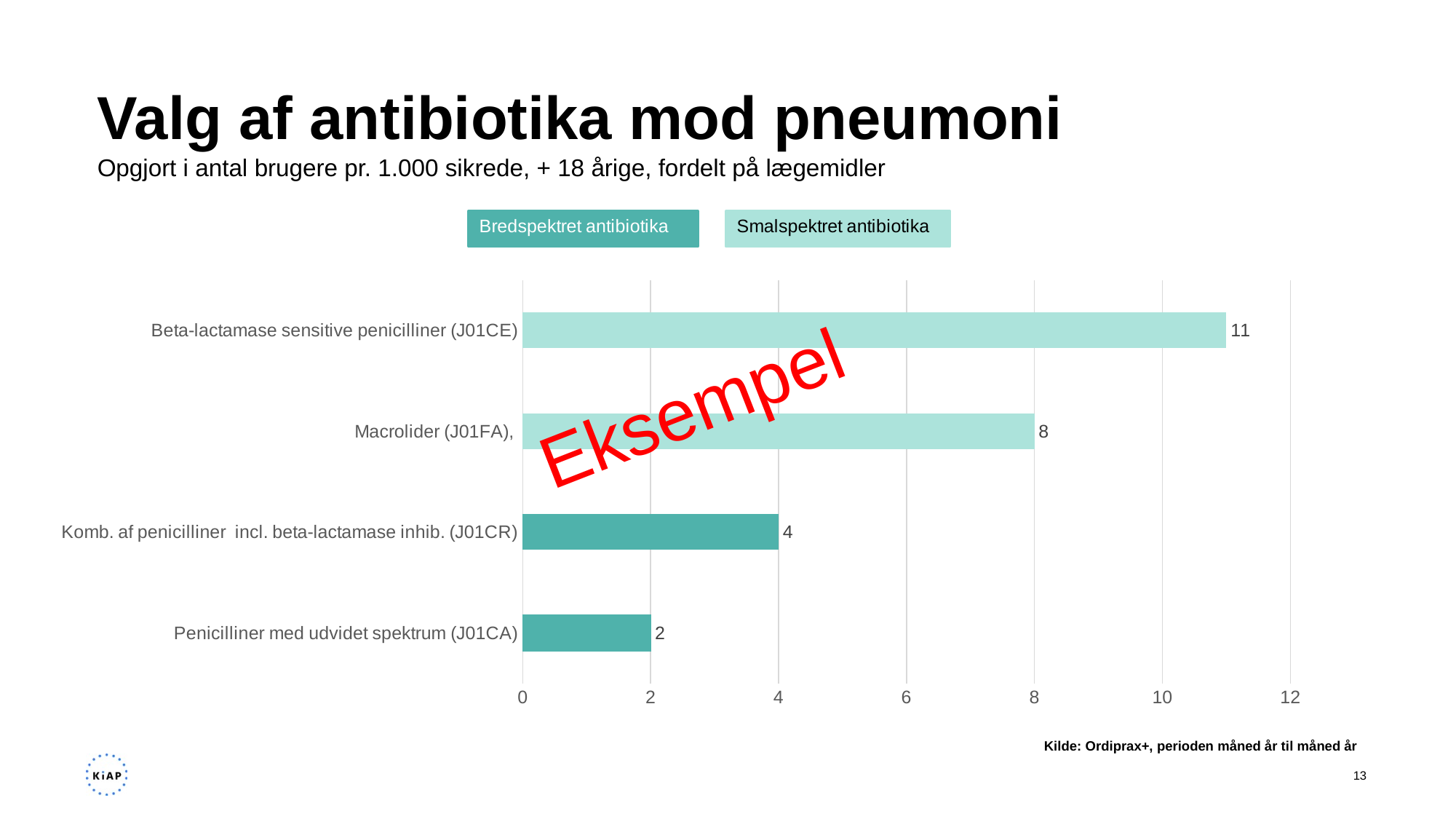
What is the value for Beta-lactamase sensitive penicilliner (J01CE)? 11 What is the value for Macrolider (J01FA)? 8 What kind of chart is shown on the slide? Bar chart Which legend entry does the bar for Macrolider (J01FA) belong to? Smalspektret antibiotika What is the value for Komb. af penicilliner incl. beta-lactamase inhib. (J01CR)? 4 Which category has the lowest value? Penicilliner med udvidet spektrum (J01CA) What is the difference between the values for Beta-lactamase sensitive penicilliner (J01CE) and Macrolider (J01FA)? 3 How many categories are shown in the chart? 4 Which category has the highest value? Beta-lactamase sensitive penicilliner (J01CE) How many series does the legend list? 2 What is the value for Penicilliner med udvidet spektrum (J01CA)? 2 Which is larger, the value for Komb. af penicilliner incl. beta-lactamase inhib. (J01CR) or Penicilliner med udvidet spektrum (J01CA)? Komb. af penicilliner incl. beta-lactamase inhib. (J01CR)